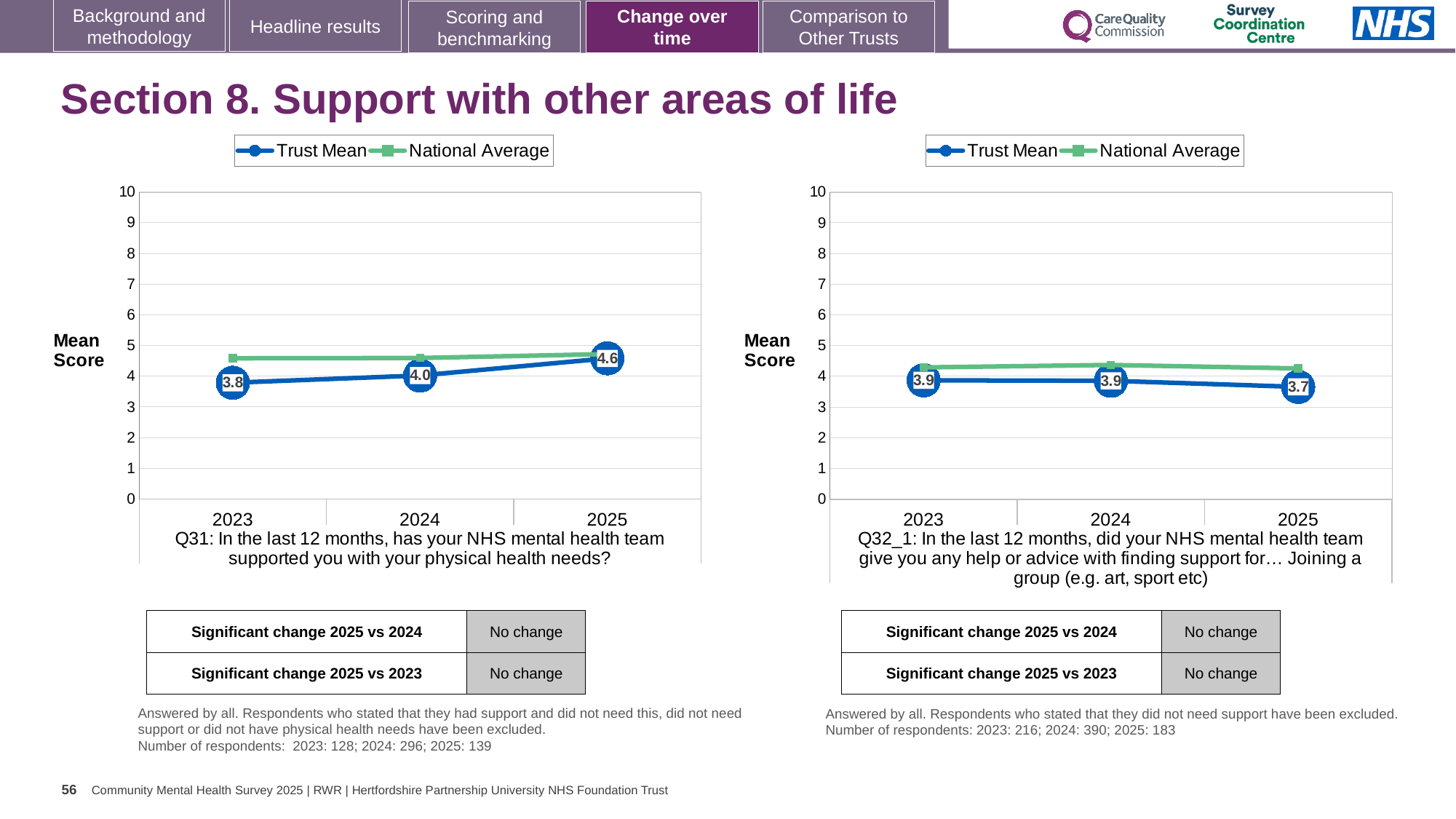
In the Q31 chart on the left, does the Trust Mean rise or fall from 2023 to 2025? Rise What type of chart is the Q31 chart on the left? Line chart In the Q31 chart on the left, which year has the highest Trust Mean score? 2025 In the Q32_1 chart on the right, what is the Trust Mean score for 2025? 3.7 How many years are plotted on the x axis of the Q32_1 chart on the right? 3 In the Q31 chart on the left, what is the difference between the Trust Mean scores for 2025 and 2023? 0.8 In the Q31 chart on the left, what is the Trust Mean score for 2025? 4.6 In the Q31 chart on the left, is the National Average value for 2023 greater or less than 4? greater How many series does the legend of the Q31 chart on the left list? 2 In the Q32_1 chart on the right, which year has the lowest Trust Mean score? 2025 In the Q32_1 chart on the right, which is higher in 2023, the Trust Mean or the National Average? National Average In the Q31 chart on the left, what is the Trust Mean score for 2023? 3.8